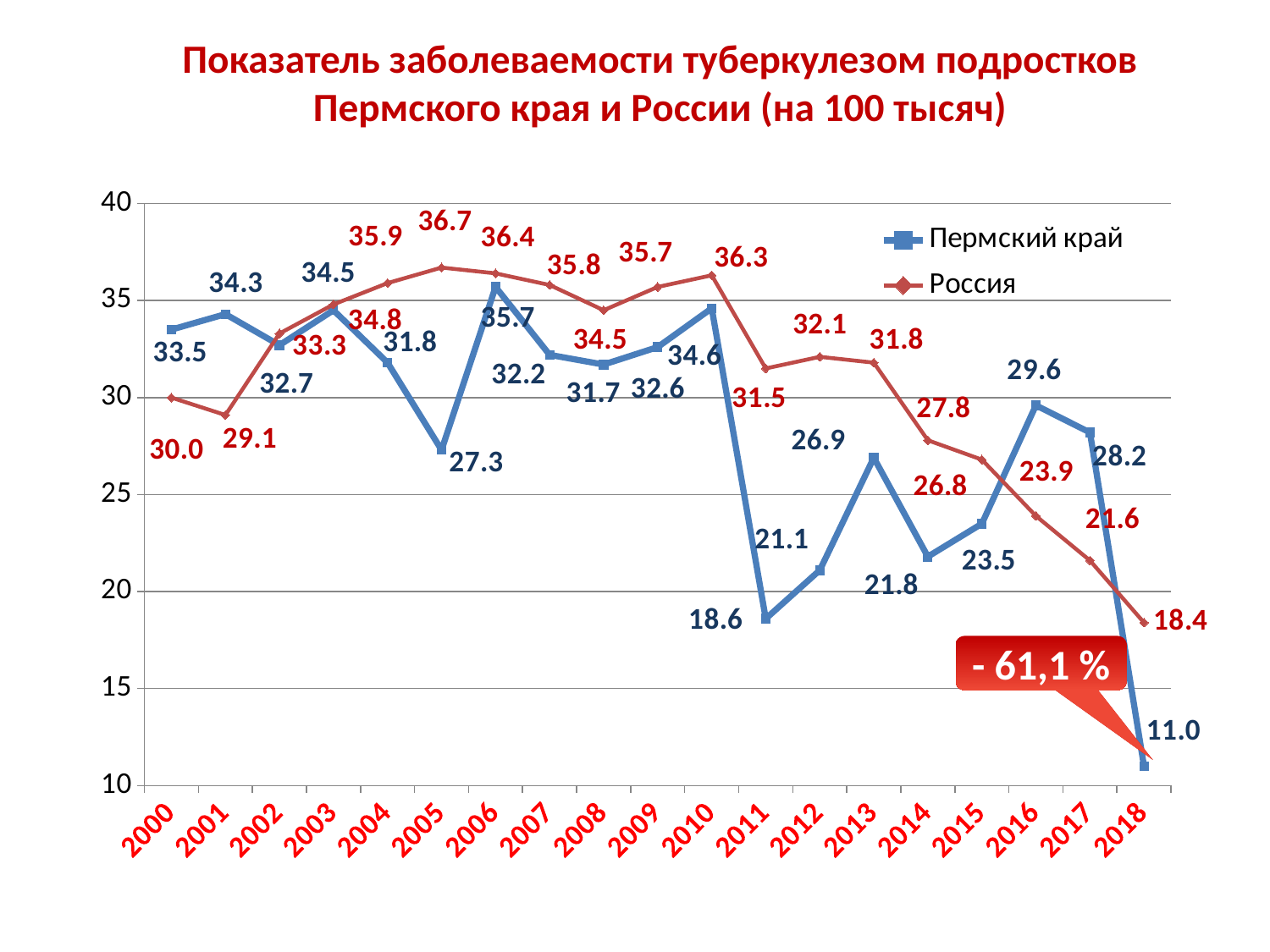
What was the value for Пермский край in 2011? 18.6 What was the value for Пермский край in 2018? 11.0 How many series does the legend list? 2 What is the difference between the Россия and Пермский край values in 2018? 7.4 In which year did Пермский край reach its highest value? 2006 Which series had the higher value in 2011, Пермский край or Россия? Россия What was the value for Россия in 2005? 36.7 What kind of chart is shown on the slide? Line chart What percentage change is shown in the callout near the 2018 point? - 61,1 % In which year was the value for Россия lowest? 2018 How many years are shown on the x axis? 19 Did the value for Россия rise or fall from 2010 to 2018? Fall